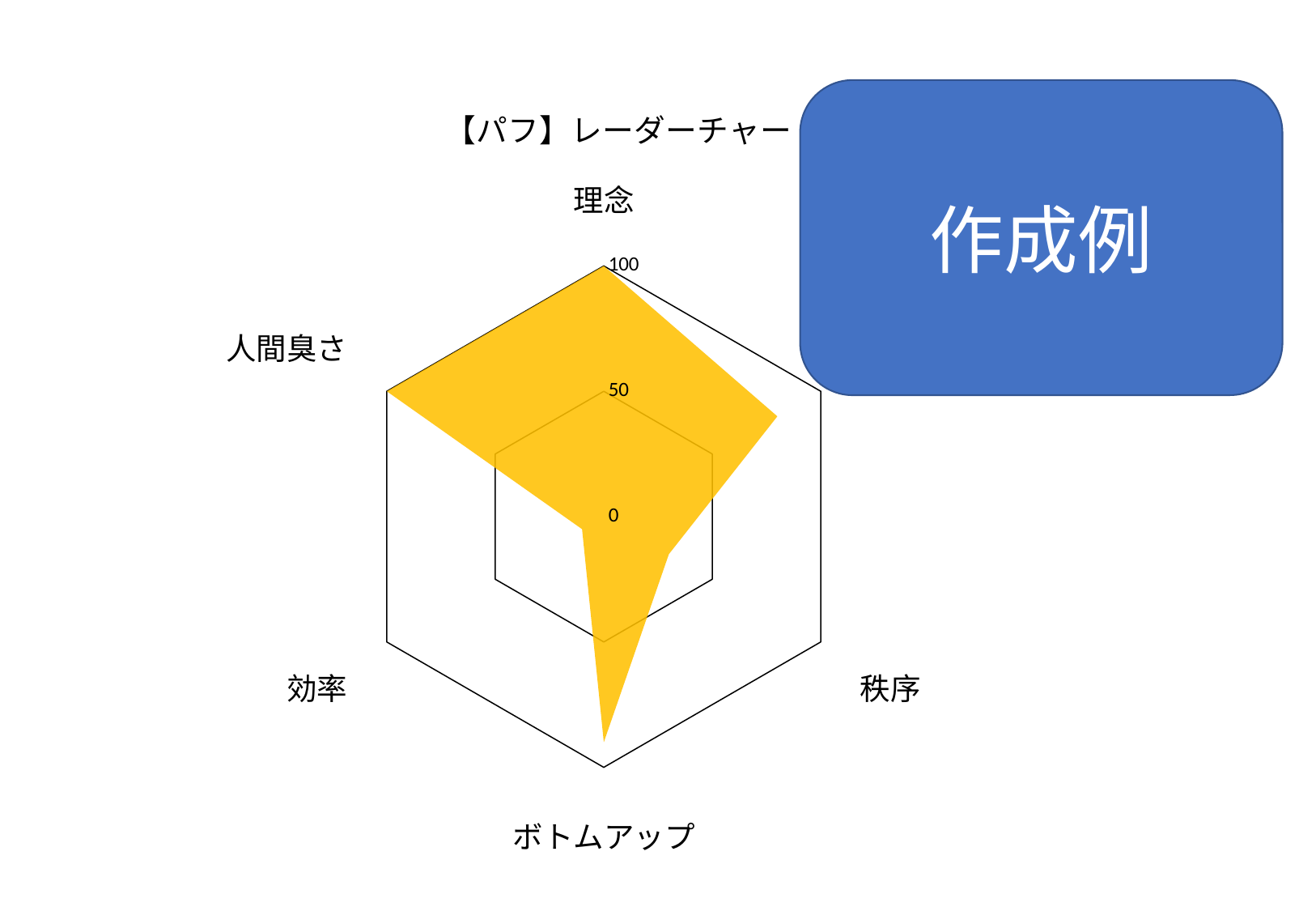
Which is larger, the value for ボトムアップ or the value for 秩序? ボトムアップ Which category has the lowest value on the radar chart? 効率 What is the maximum value shown on the radar chart's axis scale? 100 What is the value for 理念 on the radar chart? 100 Is the value for ボトムアップ greater or less than 50? greater What colour is the filled data area on the radar chart? yellow Is the value for 秩序 greater or less than 50? less What is the value for 人間臭さ on the radar chart? 100 What kind of chart is shown on the slide? radar chart How many categories (axes) does the radar chart have? 6 Which is larger, the value for 理念 or the value for 秩序? 理念